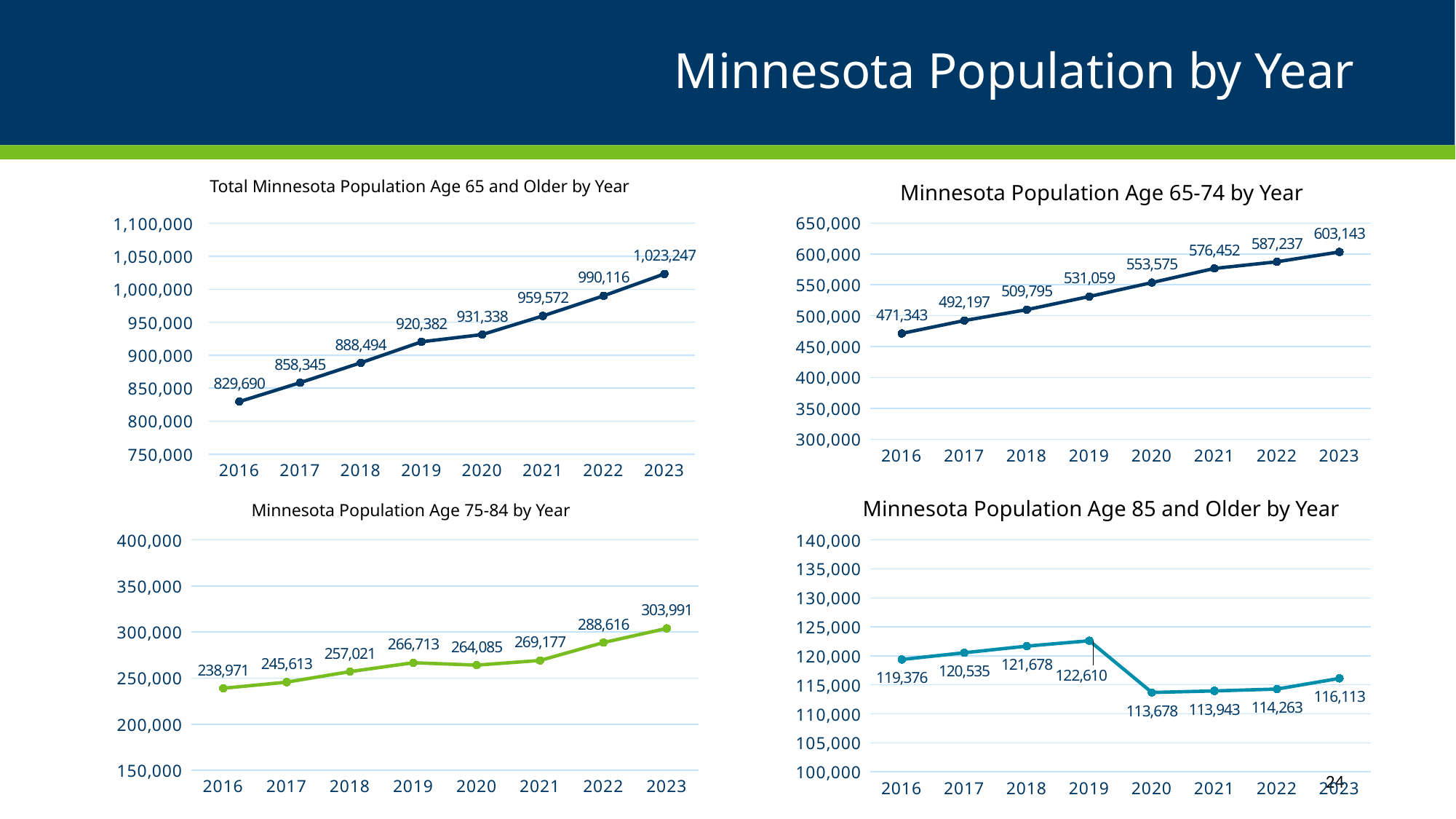
In the 'Minnesota Population Age 85 and Older by Year' chart, by how much did the value drop from 2019 to 2020? 8,932 In the 'Total Minnesota Population Age 65 and Older by Year' chart, what is the difference between the 2023 and 2016 values? 193,557 In the 'Total Minnesota Population Age 65 and Older by Year' chart, what is the value for 2023? 1,023,247 In the 'Minnesota Population Age 65-74 by Year' chart, what is the value for 2019? 531,059 In the 'Minnesota Population Age 85 and Older by Year' chart, what is the value for 2020? 113,678 In the 'Minnesota Population Age 85 and Older by Year' chart, which year has the highest value? 2019 In the 'Minnesota Population Age 65-74 by Year' chart, do the values rise or fall from 2016 to 2023? Rise In the 'Minnesota Population Age 75-84 by Year' chart, which is larger, the value for 2019 or the value for 2020? 2019 In the 'Minnesota Population Age 75-84 by Year' chart, what is the value for 2022? 288,616 What type of chart is 'Minnesota Population Age 75-84 by Year'? Line chart How many data points are plotted in the 'Minnesota Population Age 65-74 by Year' chart? 8 In the 'Minnesota Population Age 85 and Older by Year' chart, which year has the lowest value? 2020